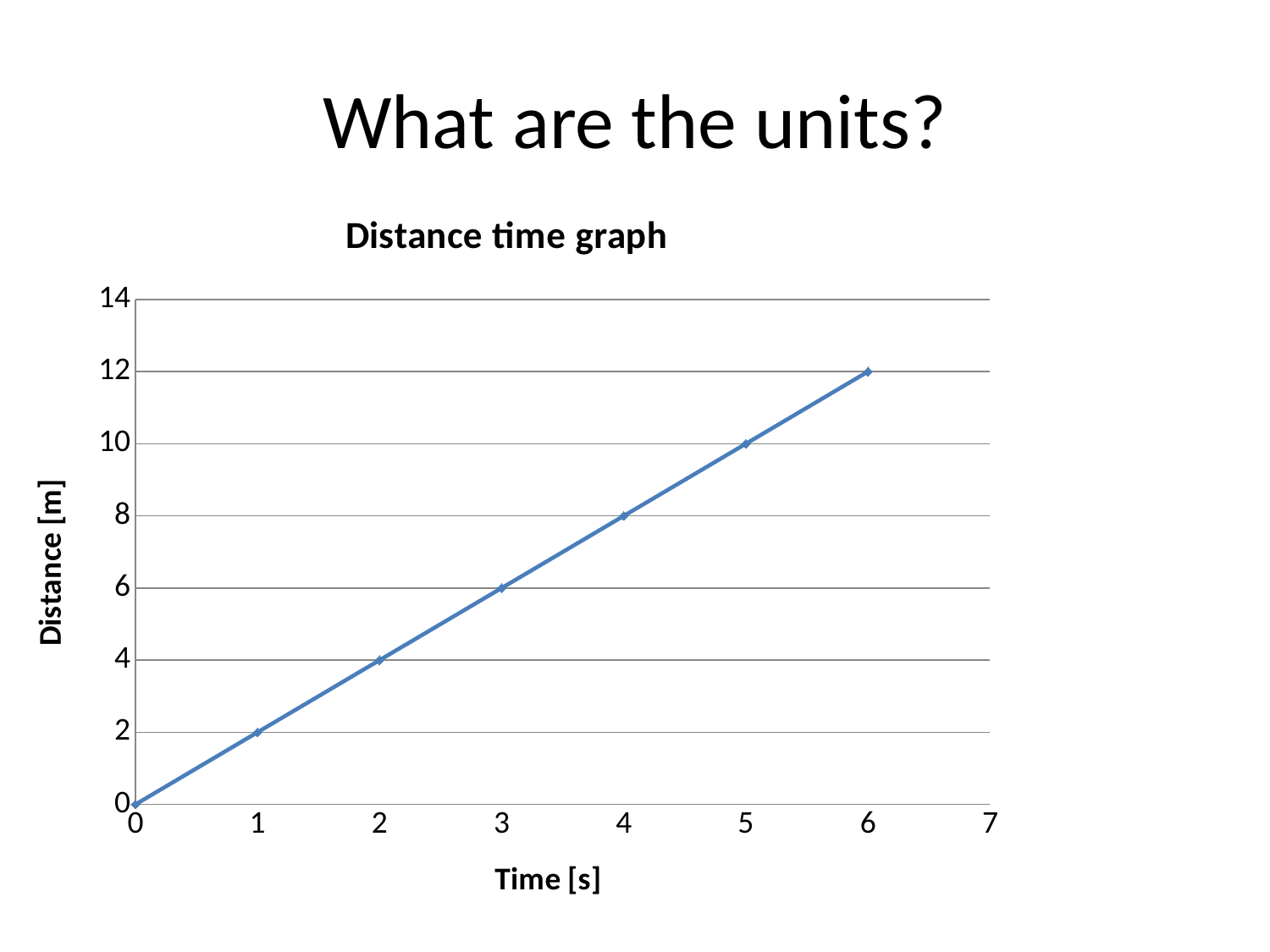
How many data points are plotted on the line? 7 What is the label of the y axis? Distance [m] Is the distance at time 5 s greater or less than 8? greater What is the distance at time 3 s? 6 What is the difference in distance between time 5 s and time 2 s? 6 Which is larger, the distance at time 4 s or at time 2 s? time 4 s What kind of chart is shown on the slide? line chart What is the title of the chart? Distance time graph What is the distance at time 1 s? 2 At which time is the distance highest? 6 Does the distance rise or fall as time increases? rise What is the distance at time 6 s? 12